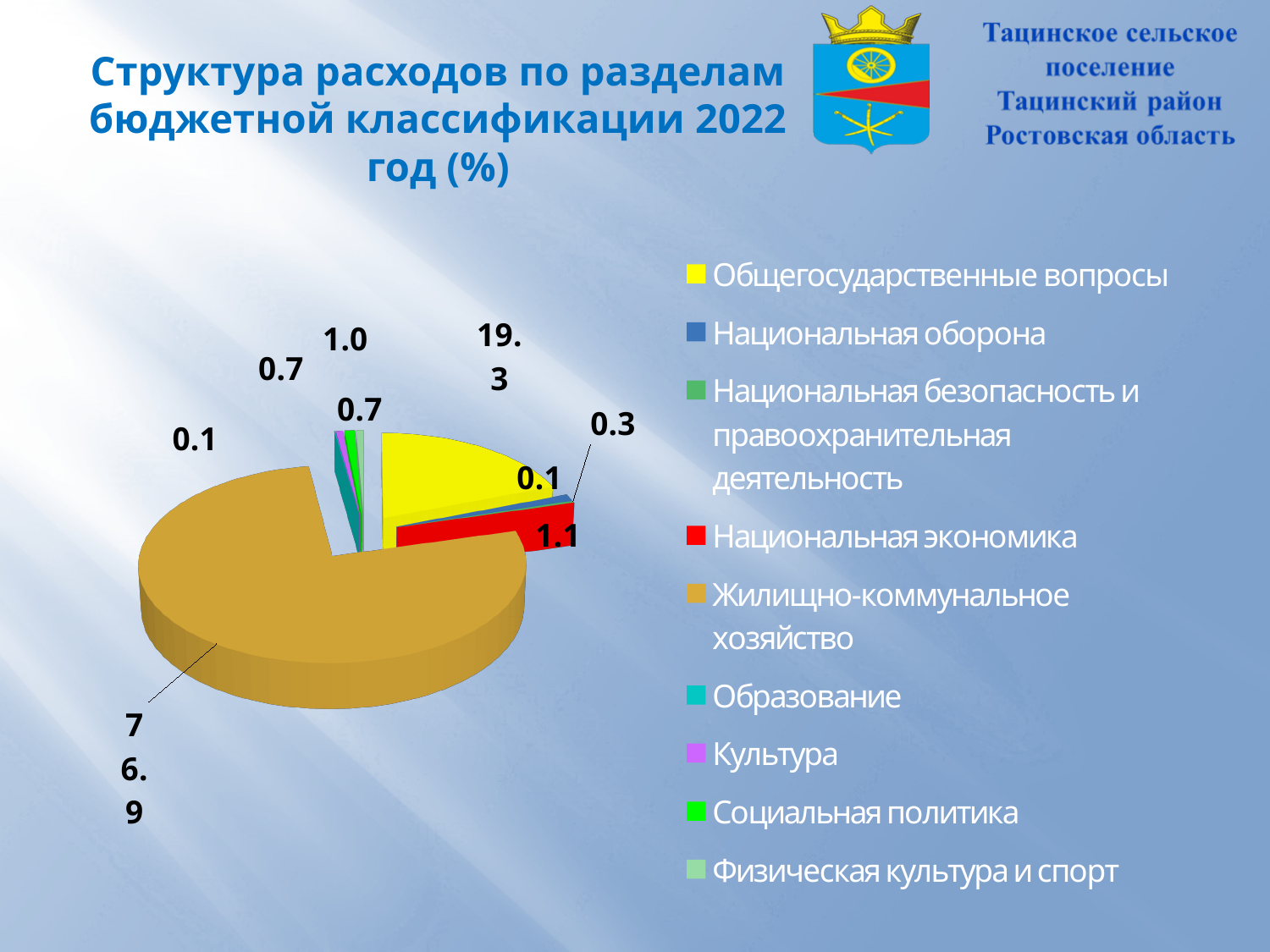
What is the difference in percentage points between Жилищно-коммунальное хозяйство and Общегосударственные вопросы? 57.6 What colour is the slice for Национальная экономика in the pie chart? red Which category has the largest share of expenditures in the pie chart? Жилищно-коммунальное хозяйство What percentage of expenditures goes to Национальная экономика? 1.1 What is the difference in percentage points between Общегосударственные вопросы and Национальная экономика? 18.2 What percentage of expenditures goes to Жилищно-коммунальное хозяйство? 76.9 Which is larger: the share for Общегосударственные вопросы or the share for Национальная экономика? Общегосударственные вопросы What kind of chart is shown on the slide? pie chart How many categories does the legend of the pie chart list? 9 What is the title of the chart on the slide? Структура расходов по разделам бюджетной классификации 2022 год (%) What percentage of expenditures goes to Общегосударственные вопросы? 19.3